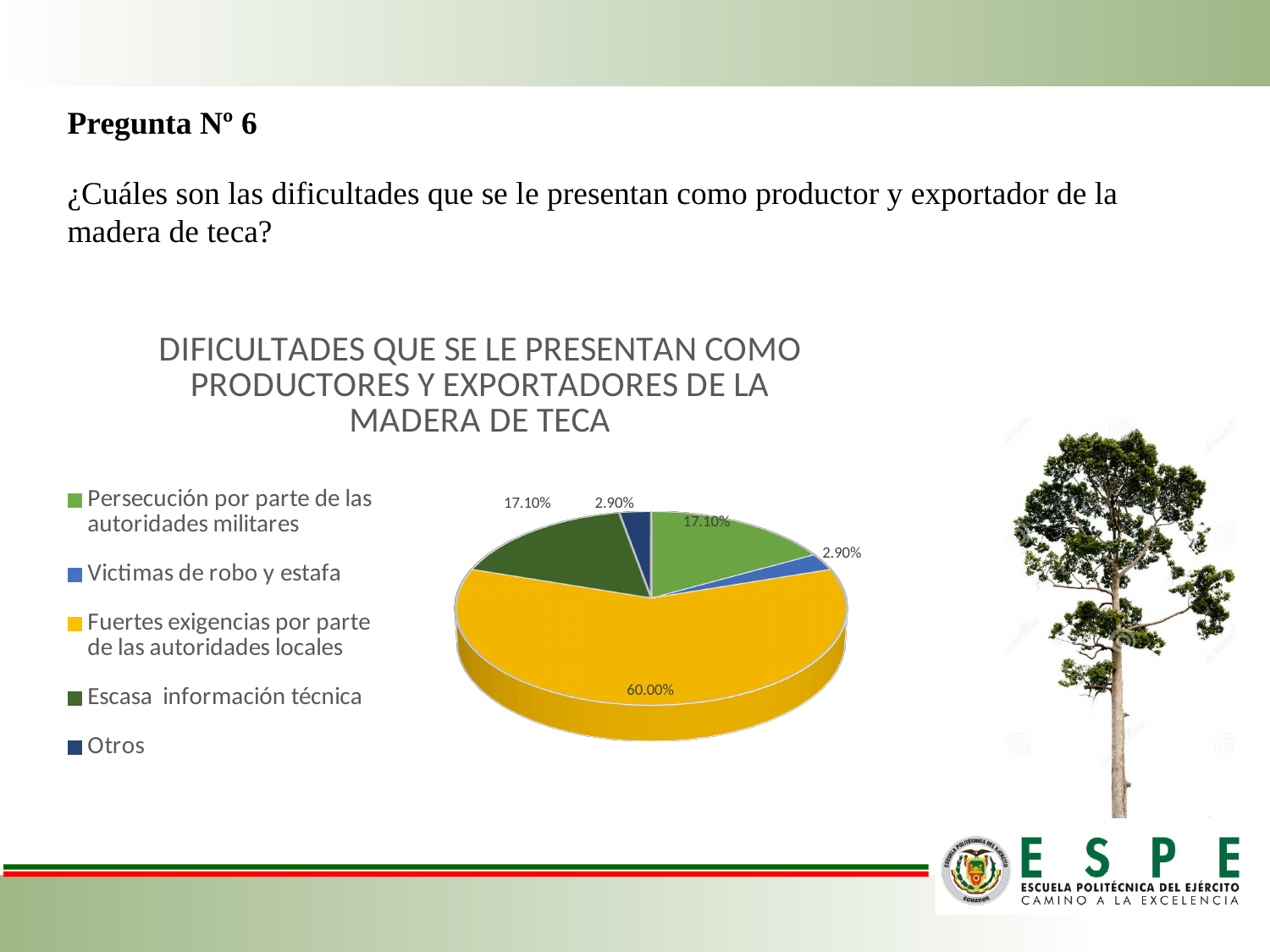
What colour represents 'Otros' in the pie chart? dark blue How many categories does the pie chart have? 5 What type of chart is shown on the slide? pie chart What percentage is shown for 'Fuertes exigencias por parte de las autoridades locales'? 60.00% What percentage is shown for 'Persecución por parte de las autoridades militares'? 17.10% What percentage is shown for 'Otros'? 2.90% What is the difference between the share for 'Fuertes exigencias por parte de las autoridades locales' and the share for 'Escasa información técnica'? 42.90% Which is larger: the share for 'Persecución por parte de las autoridades militares' or the share for 'Otros'? Persecución por parte de las autoridades militares What is the title of the chart? DIFICULTADES QUE SE LE PRESENTAN COMO PRODUCTORES Y EXPORTADORES DE LA MADERA DE TECA Which category has the largest share of the pie? Fuertes exigencias por parte de las autoridades locales What percentage is shown for 'Escasa información técnica'? 17.10% What percentage is shown for 'Victimas de robo y estafa'? 2.90%